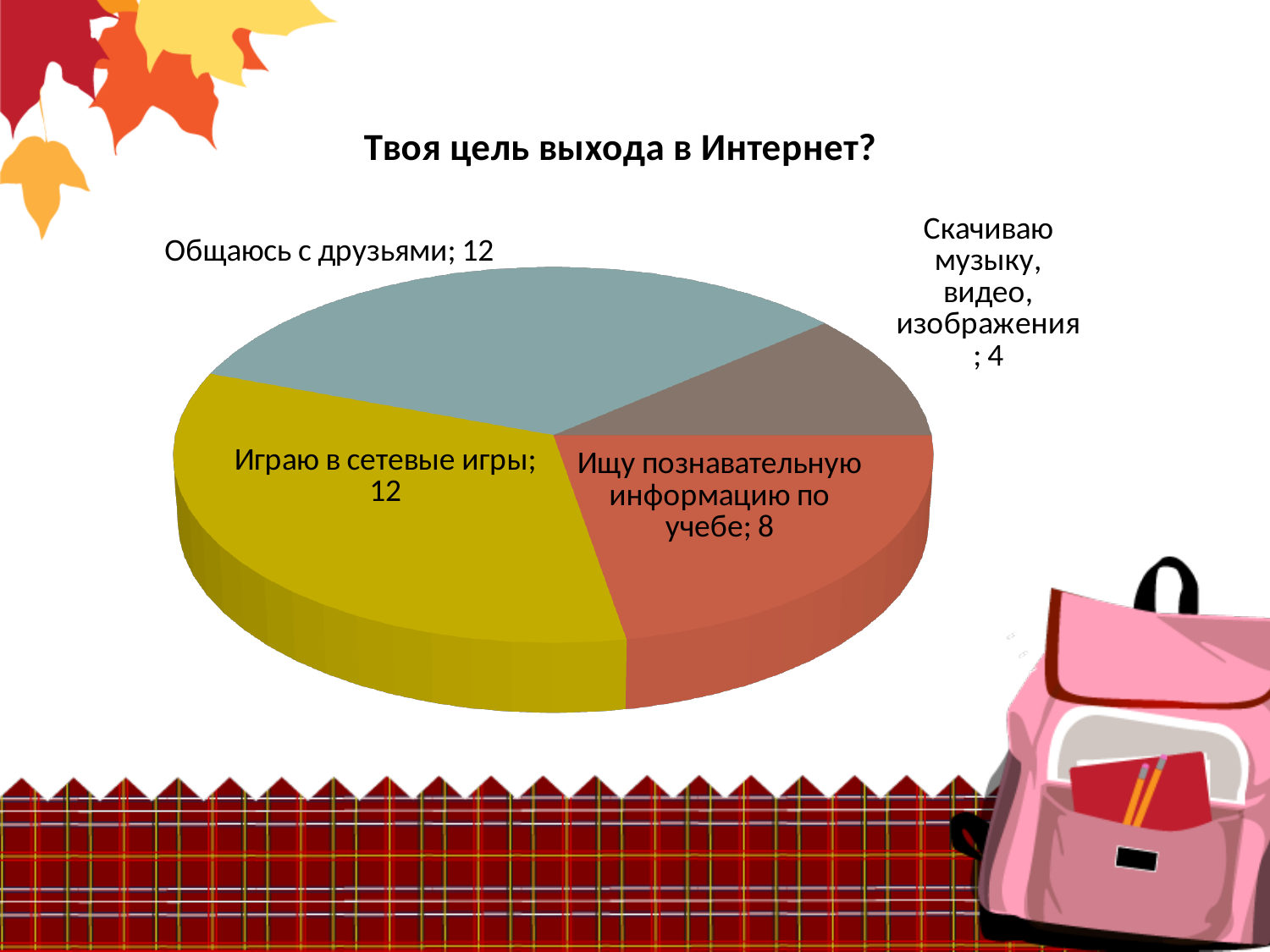
What is the value for "Общаюсь с друзьями"? 12 Which category has the smallest value? Скачиваю музыку, видео, изображения What is the difference between the values for "Ищу познавательную информацию по учебе" and "Скачиваю музыку, видео, изображения"? 4 What is the value for "Играю в сетевые игры"? 12 What is the value for "Скачиваю музыку, видео, изображения"? 4 What is the value for "Ищу познавательную информацию по учебе"? 8 How many categories does the pie chart have? 4 What kind of chart is shown on the slide? pie chart What is the total of all the values in the pie chart? 36 Which is larger: "Играю в сетевые игры" or "Ищу познавательную информацию по учебе"? Играю в сетевые игры What is the difference between the values for "Общаюсь с друзьями" and "Скачиваю музыку, видео, изображения"? 8 What is the title of the chart? Твоя цель выхода в Интернет?